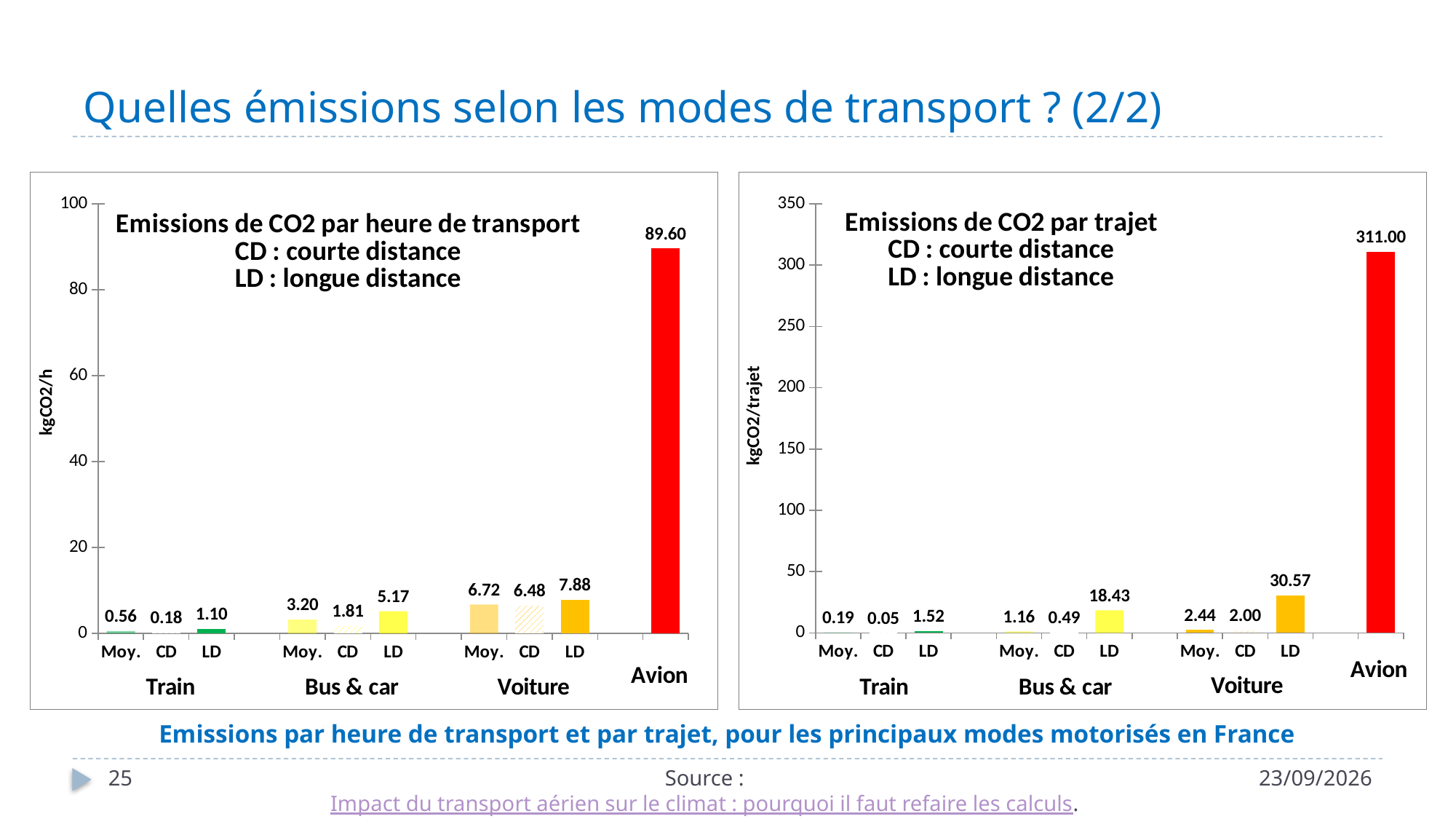
In the chart 'Emissions de CO2 par trajet', what is the difference between Voiture LD and Bus & car LD? 12.14 In the chart 'Emissions de CO2 par heure de transport', what is the value for Voiture LD? 7.88 In the chart 'Emissions de CO2 par heure de transport', what is the difference between Voiture LD and Bus & car LD? 2.71 In the chart 'Emissions de CO2 par heure de transport', what is the value for Avion? 89.60 In the chart 'Emissions de CO2 par heure de transport', which bar is the lowest? Train CD In the chart 'Emissions de CO2 par trajet', what is the value for Avion? 311.00 How many bars are plotted in the chart 'Emissions de CO2 par heure de transport'? 10 In the chart 'Emissions de CO2 par heure de transport', which is larger, Voiture Moy. or Voiture CD? Voiture Moy. In the chart 'Emissions de CO2 par trajet', what is the value for Bus & car LD? 18.43 What kind of chart is 'Emissions de CO2 par trajet'? bar chart In the chart 'Emissions de CO2 par trajet', is the value for Avion greater or less than 300? greater In the chart 'Emissions de CO2 par trajet', which bar is the highest? Avion